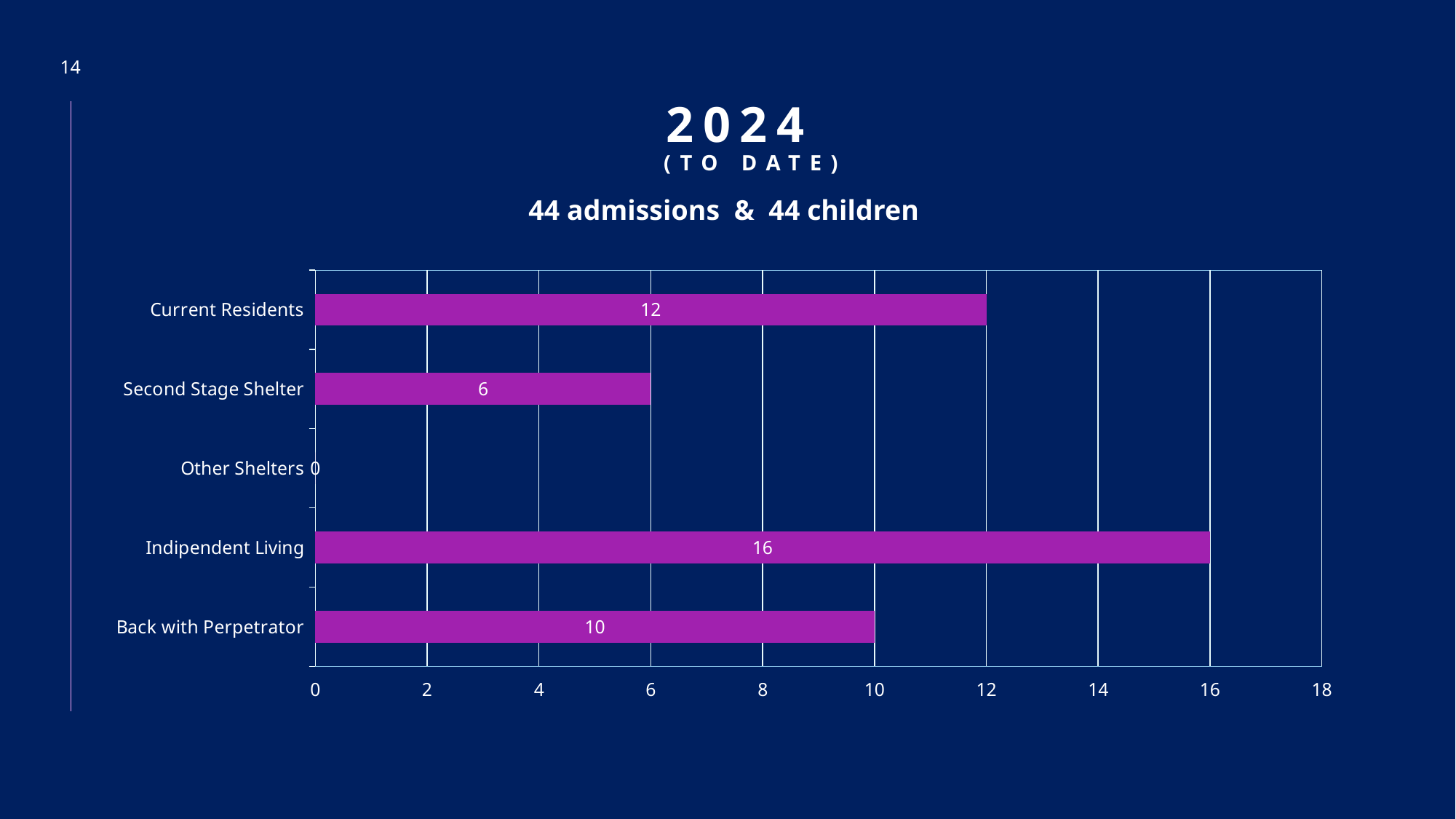
What is the value for Current Residents? 12 What is the maximum value shown on the x axis? 18 Which category has the lowest value? Other Shelters How many categories are shown on the chart? 5 Which category has the highest value? Indipendent Living What is the value for Back with Perpetrator? 10 What kind of chart is shown on the slide? Bar chart What is the difference between the values for Indipendent Living and Current Residents? 4 What is the value for Indipendent Living? 16 Which is larger, the value for Back with Perpetrator or the value for Second Stage Shelter? Back with Perpetrator What is the value for Other Shelters? 0 What is the value for Second Stage Shelter? 6